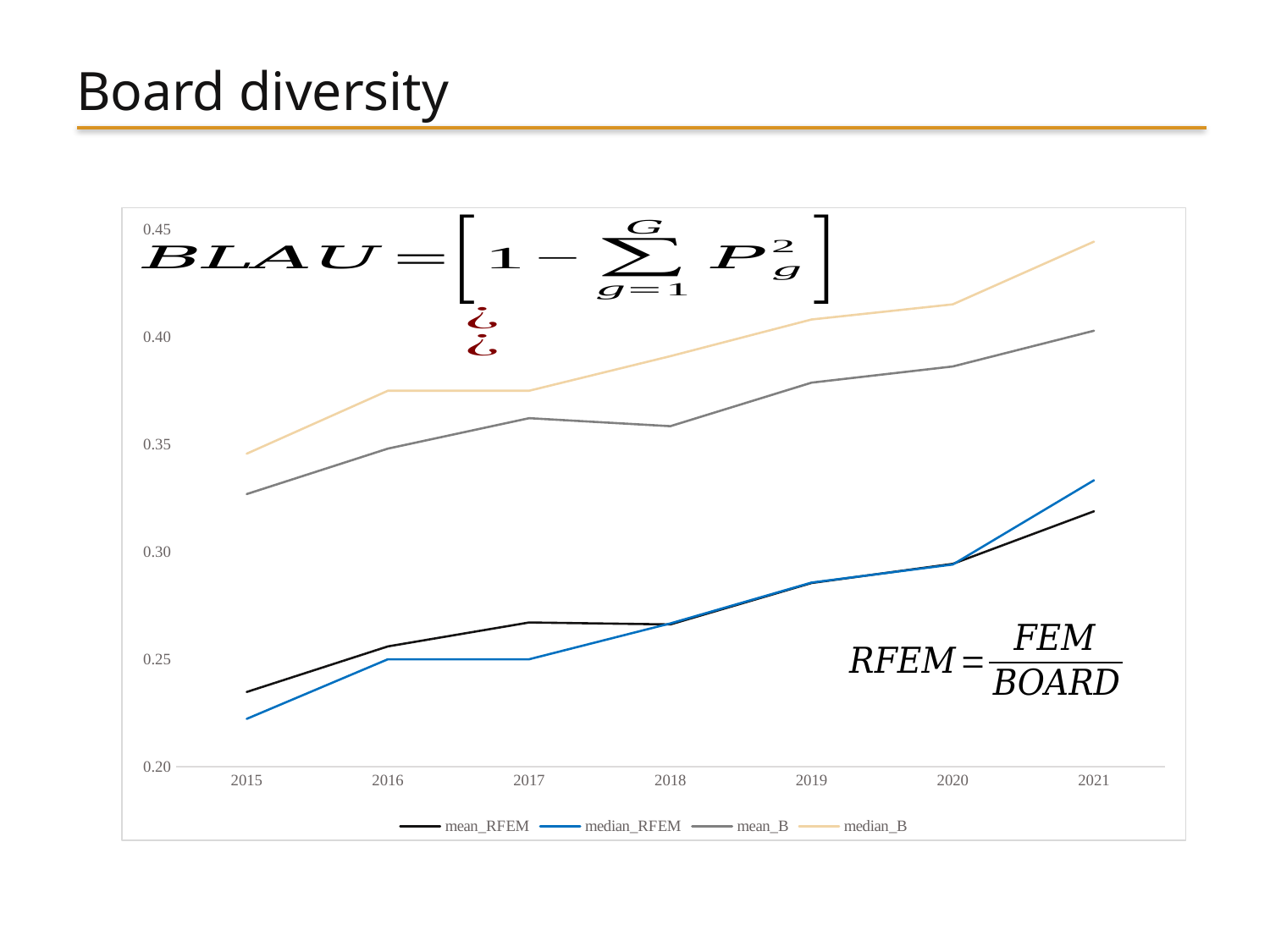
In 2015, which is larger: mean_RFEM or median_RFEM? mean_RFEM Is the value for median_B in 2018 greater or less than 0.35? greater Is the value for mean_RFEM in 2021 greater or less than 0.30? greater Is the value for median_RFEM in 2015 greater or less than 0.25? less How many years are shown on the x axis? 7 How many series does the legend list? 4 Does the median_B series rise or fall from 2015 to 2021? rise In which year is median_B at its highest? 2021 In 2021, which is larger: median_B or mean_B? median_B What kind of chart is shown on the slide? line chart